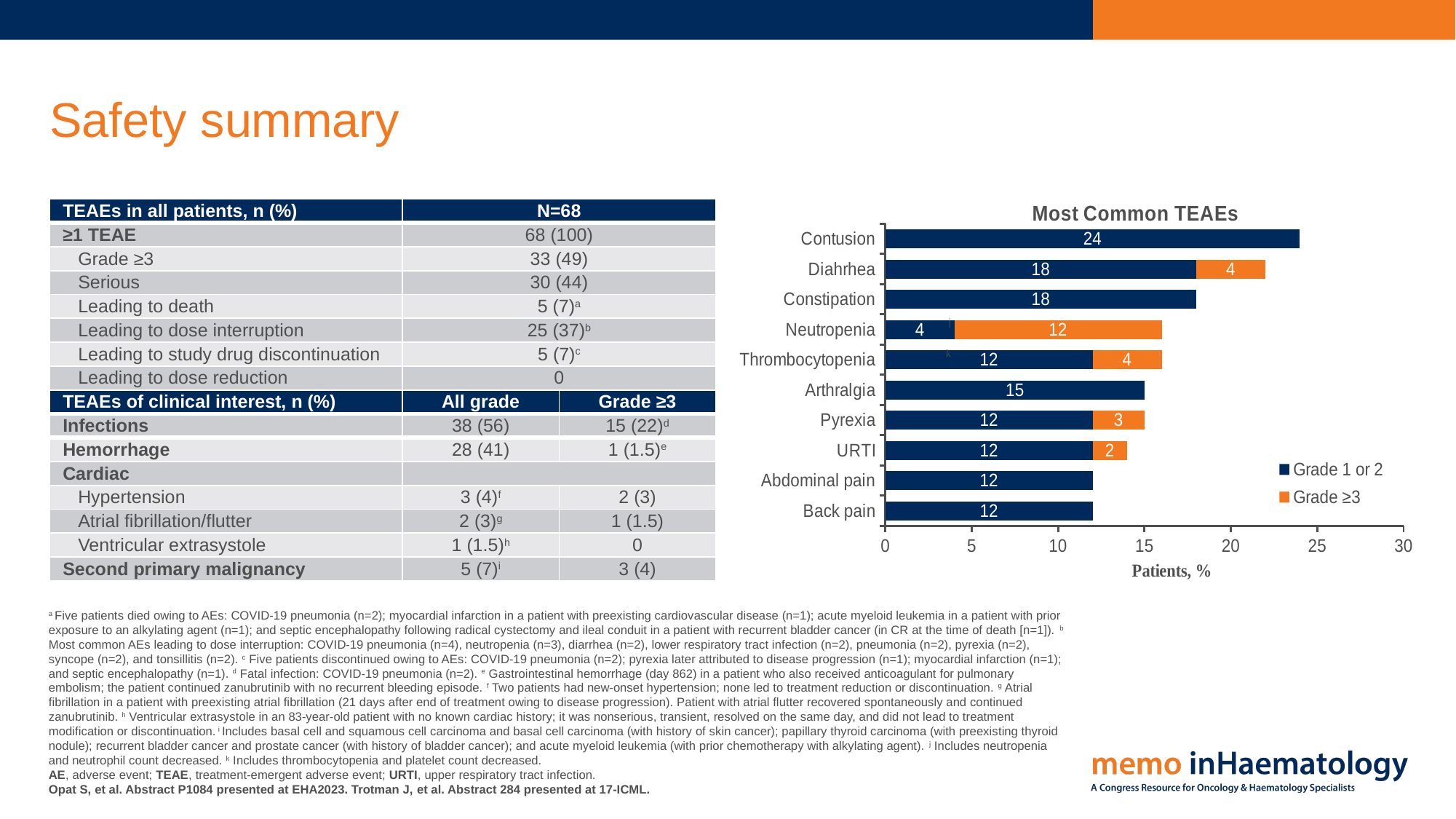
In the "Most Common TEAEs" chart, what is the difference between the Grade 1 or 2 values for Contusion and Arthralgia? 9 How many adverse event categories are plotted in the "Most Common TEAEs" chart? 10 In the "Most Common TEAEs" chart, which is larger: the Grade ≥3 value for Pyrexia or the Grade ≥3 value for URTI? Pyrexia In the "Most Common TEAEs" chart, which category has the highest total bar? Contusion In the "Most Common TEAEs" chart, what is the total of the stacked bar for Diahrhea? 22 In the "Most Common TEAEs" chart, what is the Grade 1 or 2 value for Contusion? 24 What type of chart is shown under the title "Most Common TEAEs"? Stacked bar chart What is the x-axis label of the "Most Common TEAEs" chart? Patients, % In the "Most Common TEAEs" chart, what is the total of the stacked bar for Neutropenia? 16 In the "Most Common TEAEs" chart, what is the Grade ≥3 value for Neutropenia? 12 In the "Most Common TEAEs" chart, what is the Grade ≥3 value for Diahrhea? 4 How many series does the legend of the "Most Common TEAEs" chart list? 2